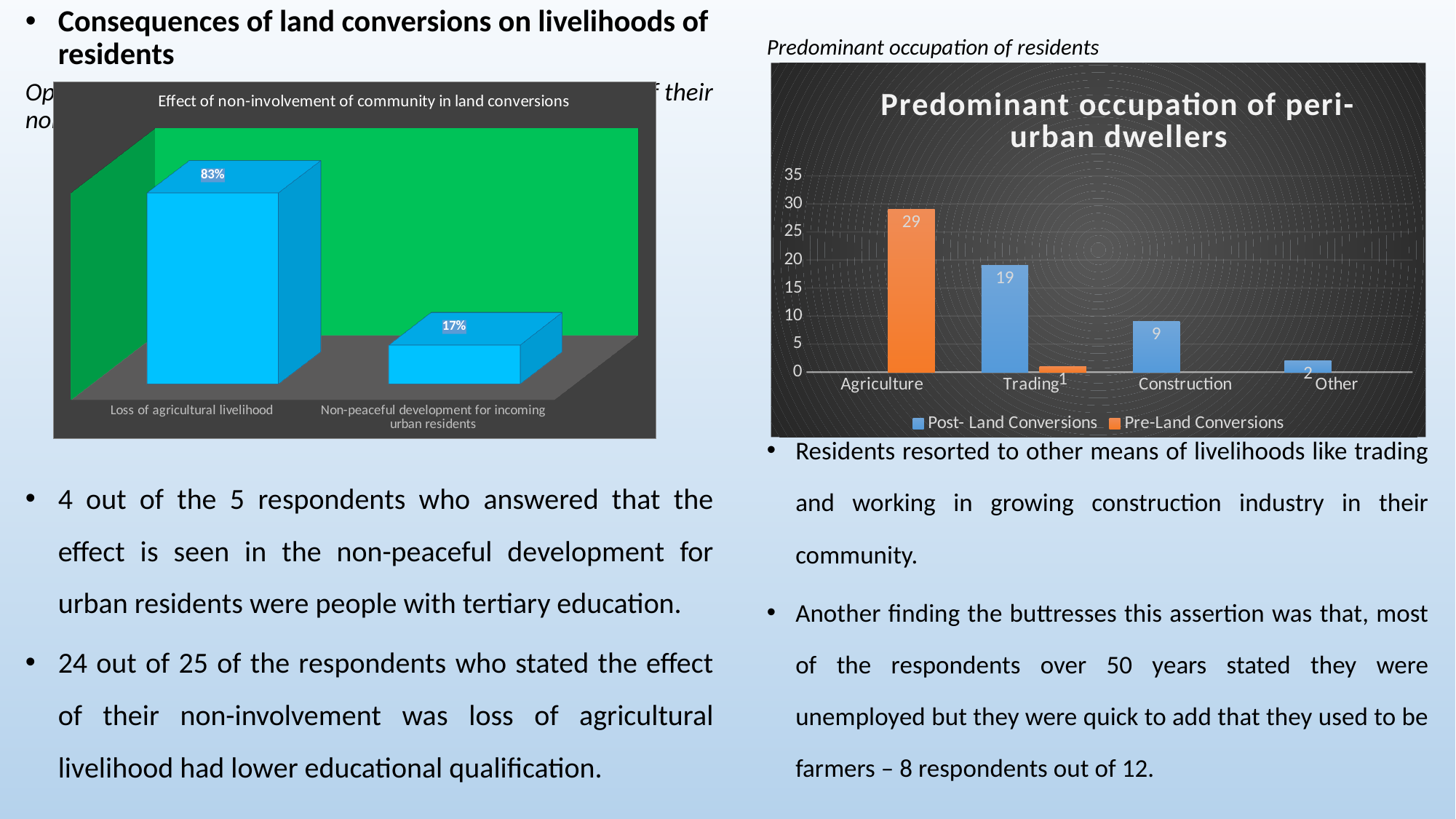
In the 'Predominant occupation of peri-urban dwellers' chart, what is the difference between the Post-Land Conversions values for Trading and Construction? 10 In the 'Predominant occupation of peri-urban dwellers' chart, what is the Post-Land Conversions value for Construction? 9 In the 'Predominant occupation of peri-urban dwellers' chart, what is the Post-Land Conversions value for Trading? 19 In the 'Effect of non-involvement of community in land conversions' chart, which category has the highest value? Loss of agricultural livelihood What type of chart is 'Effect of non-involvement of community in land conversions'? Bar chart How many categories are shown in the 'Effect of non-involvement of community in land conversions' chart? 2 In the 'Effect of non-involvement of community in land conversions' chart, what is the value for Loss of agricultural livelihood? 83% In the 'Effect of non-involvement of community in land conversions' chart, what is the value for Non-peaceful development for incoming urban residents? 17% In the 'Effect of non-involvement of community in land conversions' chart, what is the difference between the two categories' values? 66% In the 'Predominant occupation of peri-urban dwellers' chart, which category has the highest Post-Land Conversions value? Trading In the 'Predominant occupation of peri-urban dwellers' chart, how many series does the legend list? 2 In the 'Predominant occupation of peri-urban dwellers' chart, what is the Pre-Land Conversions value for Agriculture? 29